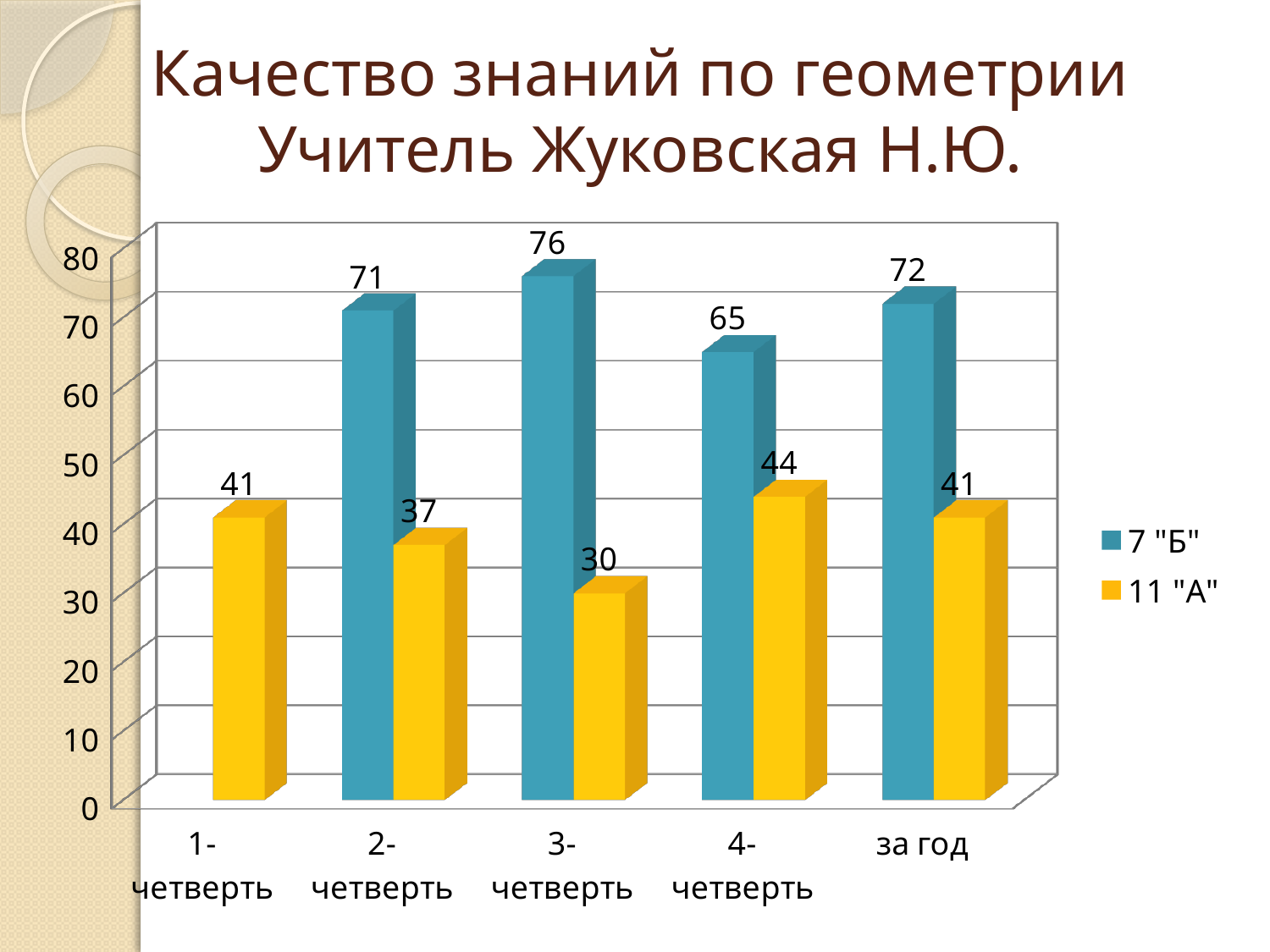
How many series does the legend list? 2 Which series is shown in yellow? 11 "А" In which category is the value for 7 "Б" the highest? 3-четверть How many categories are shown on the x axis? 5 What is the value for 11 "А" in 4-четверть? 44 What is the value for 7 "Б" in 3-четверть? 76 What kind of chart is shown on the slide? bar chart In which category is the value for 11 "А" the lowest? 3-четверть What is the value for 11 "А" in 1-четверть? 41 What is the value for 7 "Б" за год? 72 Which is larger in 4-четверть: the value for 7 "Б" or for 11 "А"? 7 "Б" What is the difference between the 7 "Б" and 11 "А" values in 2-четверть? 34